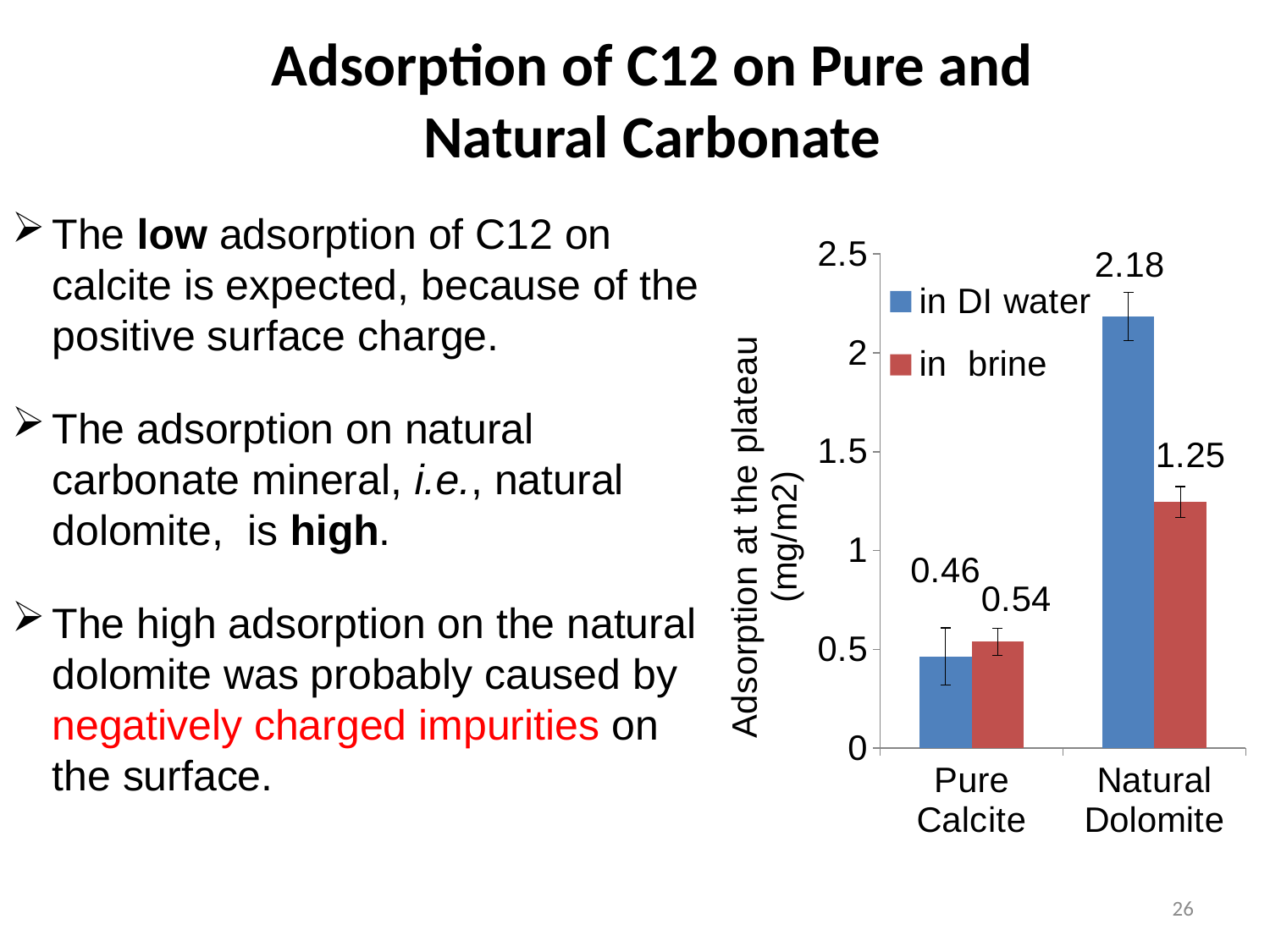
What is the label of the y axis? Adsorption at the plateau (mg/m2) How many series does the legend list? 2 Which bar shows the highest adsorption value? Natural Dolomite in DI water Which bar shows the lowest adsorption value? Pure Calcite in DI water For Natural Dolomite, is adsorption higher in DI water or in brine? in DI water What is the adsorption at the plateau for Natural Dolomite in brine? 1.25 What is the difference between the DI water and brine adsorption values for Natural Dolomite? 0.93 What is the adsorption at the plateau for Pure Calcite in DI water? 0.46 What is the adsorption at the plateau for Natural Dolomite in DI water? 2.18 What is the adsorption at the plateau for Pure Calcite in brine? 0.54 What is the difference between the brine and DI water adsorption values for Pure Calcite? 0.08 What type of chart is shown on the slide? bar chart